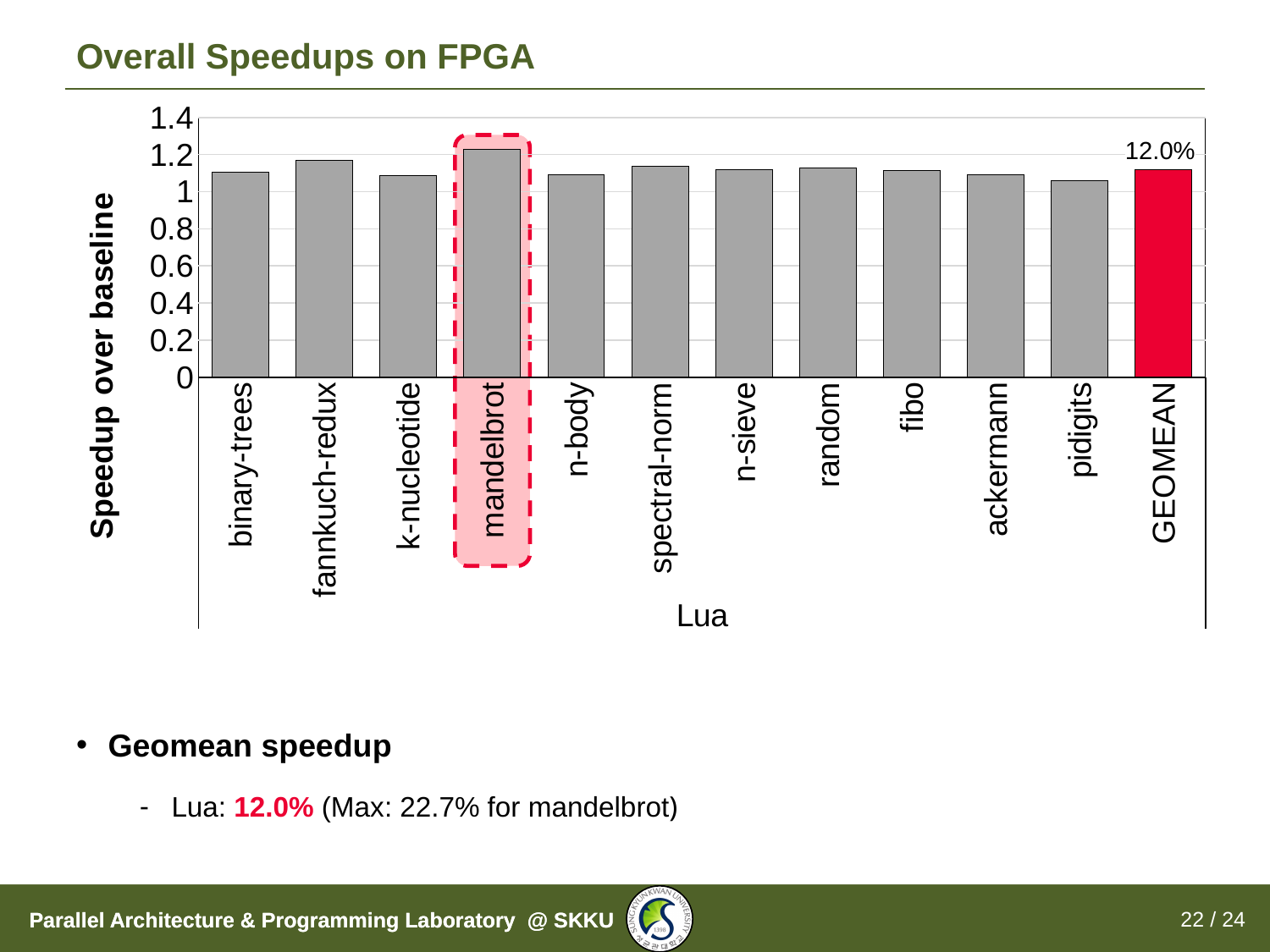
Which benchmark has the highest speedup over baseline? mandelbrot Is the speedup for fannkuch-redux greater or less than 1.2? less Which has a larger speedup over baseline, fannkuch-redux or pidigits? fannkuch-redux What is the title of the y axis? Speedup over baseline Which bar is coloured red instead of grey? GEOMEAN Which benchmark has the lowest speedup over baseline? pidigits Is the speedup for binary-trees greater or less than 1? greater What data label is printed above the GEOMEAN bar? 12.0% Which has a larger speedup over baseline, mandelbrot or k-nucleotide? mandelbrot How many bars are plotted in the chart? 12 Is the speedup for pidigits greater or less than 1.2? less What kind of chart is shown on the slide? bar chart